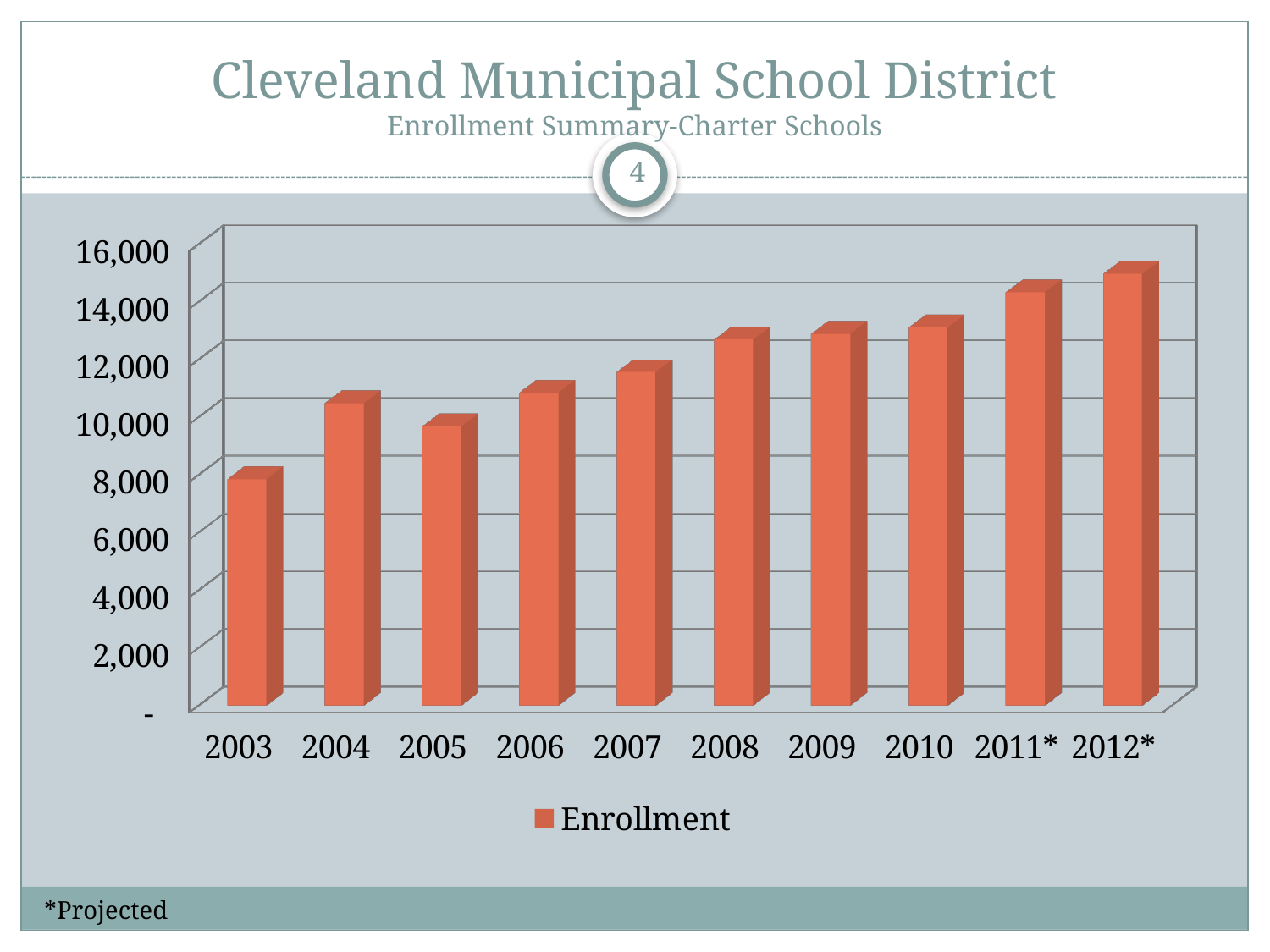
What kind of chart is shown on the slide? Bar chart Which year has the lowest enrollment in the chart? 2003 What does the asterisk on the 2011* and 2012* labels indicate, according to the slide? Projected Is the enrollment for 2003 greater or less than 10,000? less Is the enrollment for 2004 greater or less than 10,000? greater Is the enrollment for 2008 greater or less than 12,000? greater Overall, does enrollment rise or fall from 2003 to 2012*? Rises Which year has the highest enrollment in the chart? 2012* How many years are plotted on the x axis of the chart? 10 How many series does the chart's legend list? 1 Which year has the larger enrollment, 2004 or 2005? 2004